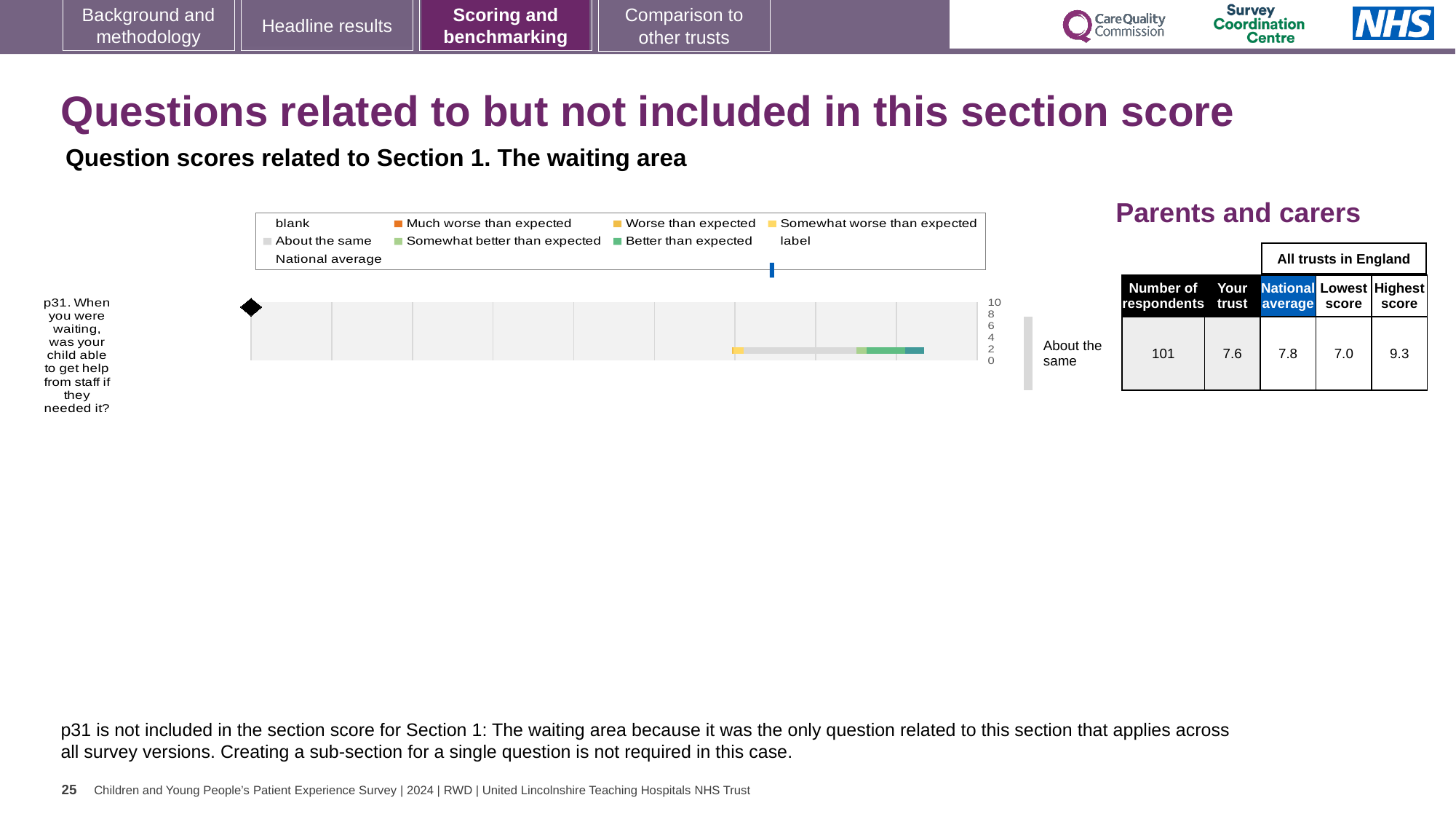
In the table next to the chart, what is the Highest score across all trusts in England for p31? 9.3 How many questions are plotted in the chart? 1 What is the maximum value shown on the chart's axis? 10 Which is larger for p31, the 'Your trust' score or the National average? National average In the table next to the chart, what is the 'Your trust' score for p31? 7.6 How many respondents answered p31 according to the table next to the chart? 101 What is the difference between the Highest score and the Lowest score for p31 in the table? 2.3 What kind of chart is shown for question p31? bar chart In the table next to the chart, what is the National average score for p31? 7.8 Which question is plotted in the chart? p31. When you were waiting, was your child able to get help from staff if they needed it? In the table next to the chart, what is the Lowest score across all trusts in England for p31? 7.0 What benchmark category label is shown to the right of the bar for p31? About the same